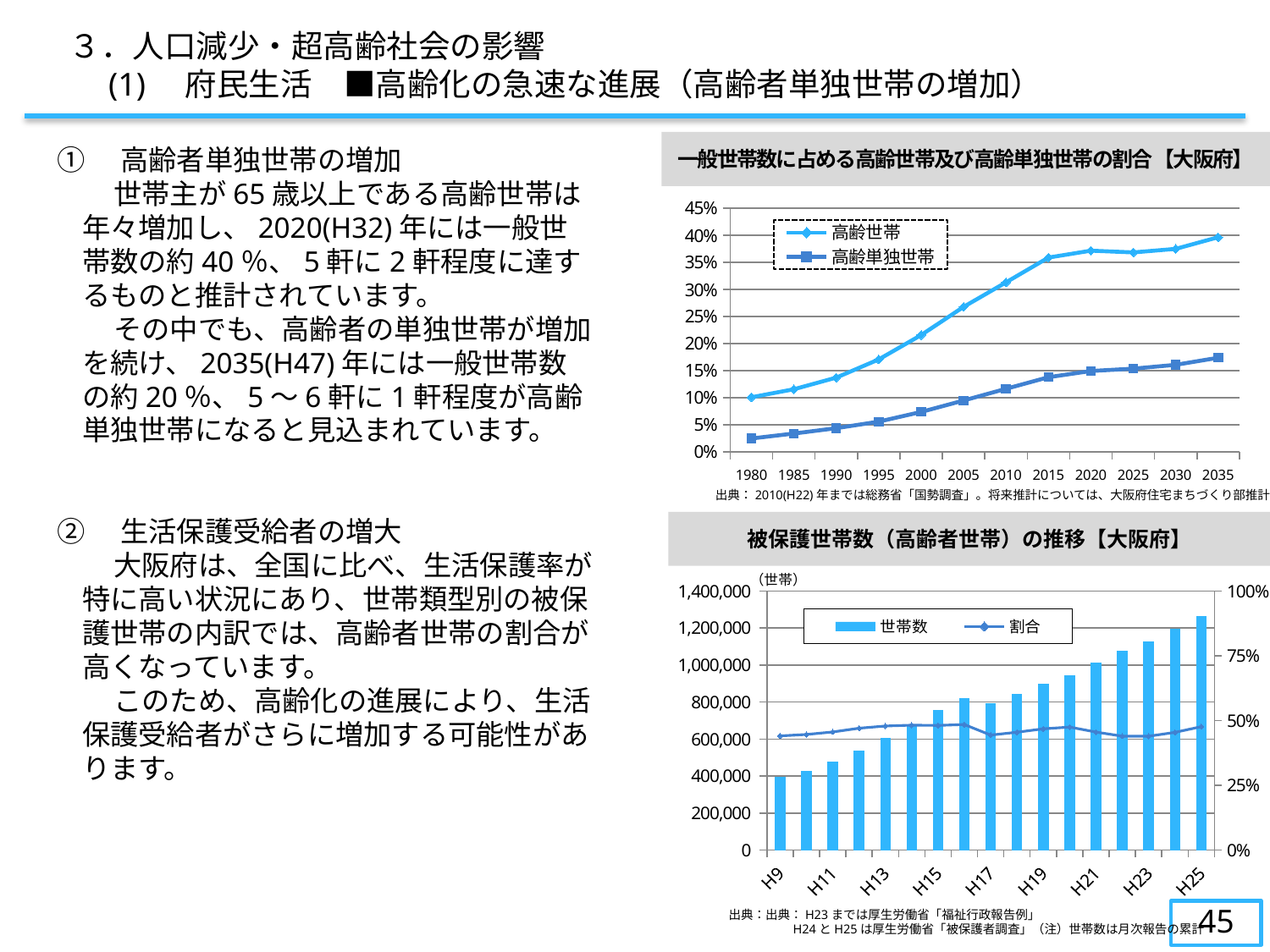
In the top chart (一般世帯数に占める高齢世帯及び高齢単独世帯の割合), which series has the higher value in 2020, 高齢世帯 or 高齢単独世帯? 高齢世帯 What kind of chart is the top chart titled 一般世帯数に占める高齢世帯及び高齢単独世帯の割合【大阪府】? line chart In the bottom chart (被保護世帯数（高齢者世帯）の推移【大阪府】), what are the two legend entries? 世帯数 and 割合 In the top chart (一般世帯数に占める高齢世帯及び高齢単独世帯の割合), how many years are shown on the x axis? 12 In the bottom chart (被保護世帯数（高齢者世帯）の推移【大阪府】), how many bars are shown? 17 In the top chart (一般世帯数に占める高齢世帯及び高齢単独世帯の割合), in which year is the value for 高齢世帯 lowest? 1980 In the bottom chart (被保護世帯数（高齢者世帯）の推移【大阪府】), which year has the highest 世帯数 bar? H25 In the bottom chart (被保護世帯数（高齢者世帯）の推移【大阪府】), is the 世帯数 value for H9 greater or less than 600,000? less In the top chart (一般世帯数に占める高齢世帯及び高齢単独世帯の割合), is the value for 高齢単独世帯 in 1980 greater or less than 5%? less In the top chart (一般世帯数に占める高齢世帯及び高齢単独世帯の割合), how many series does the legend list? 2 In the top chart (一般世帯数に占める高齢世帯及び高齢単独世帯の割合), do the values for 高齢単独世帯 rise or fall from 1980 to 2035? rise In the top chart (一般世帯数に占める高齢世帯及び高齢単独世帯の割合), is the value for 高齢世帯 in 2035 greater or less than 35%? greater